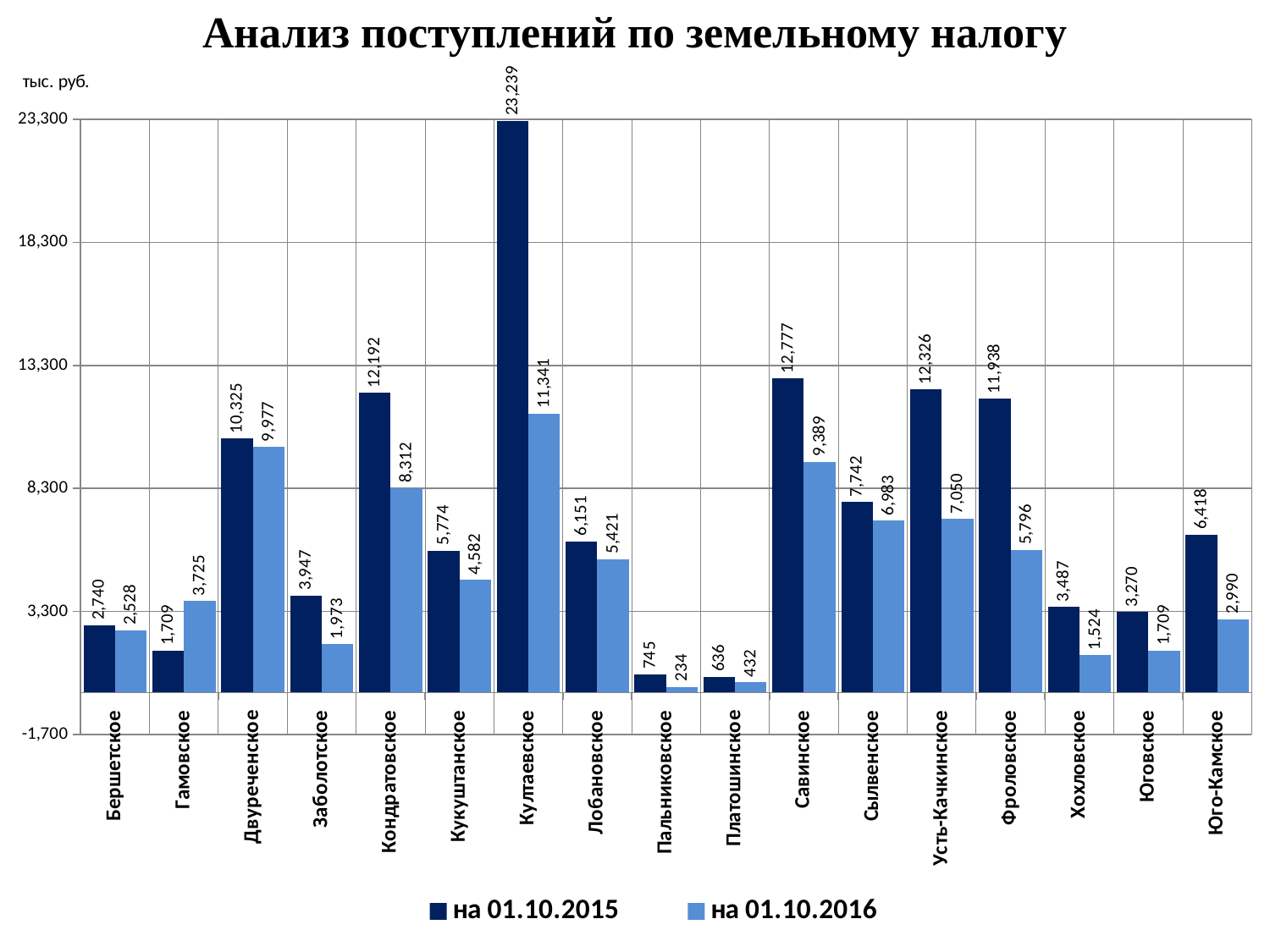
What is the value for Пальниковское in the series на 01.10.2016? 234 Which category has the lowest value in the series на 01.10.2016? Пальниковское Which category has the lowest value in the series на 01.10.2015? Платошинское For Гамовское, which series has the larger value: на 01.10.2015 or на 01.10.2016? на 01.10.2016 What is the difference between the на 01.10.2015 and на 01.10.2016 values for Култаевское? 11,898 What kind of chart is shown on the slide? Bar chart How many series does the legend list? 2 What is the value for Култаевское in the series на 01.10.2015? 23,239 What is the value for Савинское in the series на 01.10.2016? 9,389 Which category has the highest value in the series на 01.10.2015? Култаевское What unit is indicated above the vertical axis? тыс. руб. How many categories are shown on the x axis? 17